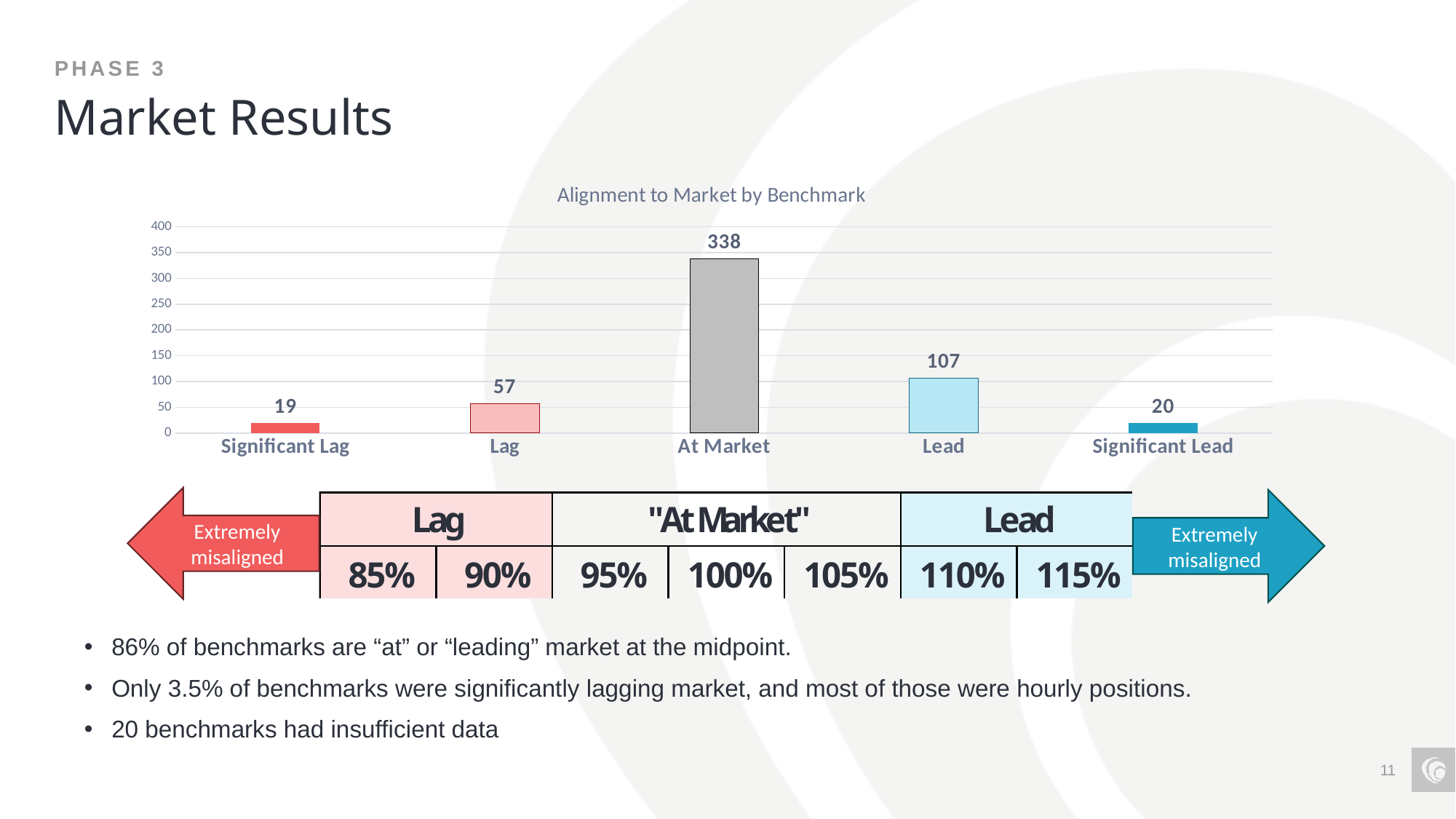
What kind of chart is shown on the slide? Bar chart What is the value for Significant Lag in the chart? 19 Which category has the lowest value in the chart? Significant Lag What is the difference between the Lag and Significant Lag values? 38 Which is larger, the value for Lag or the value for Lead? Lead Which category has the highest value in the chart? At Market How many categories are shown on the x axis of the chart? 5 What is the value for Lead in the chart? 107 What is the difference between the At Market and Lead values? 231 What is the value for At Market in the Alignment to Market by Benchmark chart? 338 What is the value for Significant Lead in the chart? 20 What is the title of the chart? Alignment to Market by Benchmark